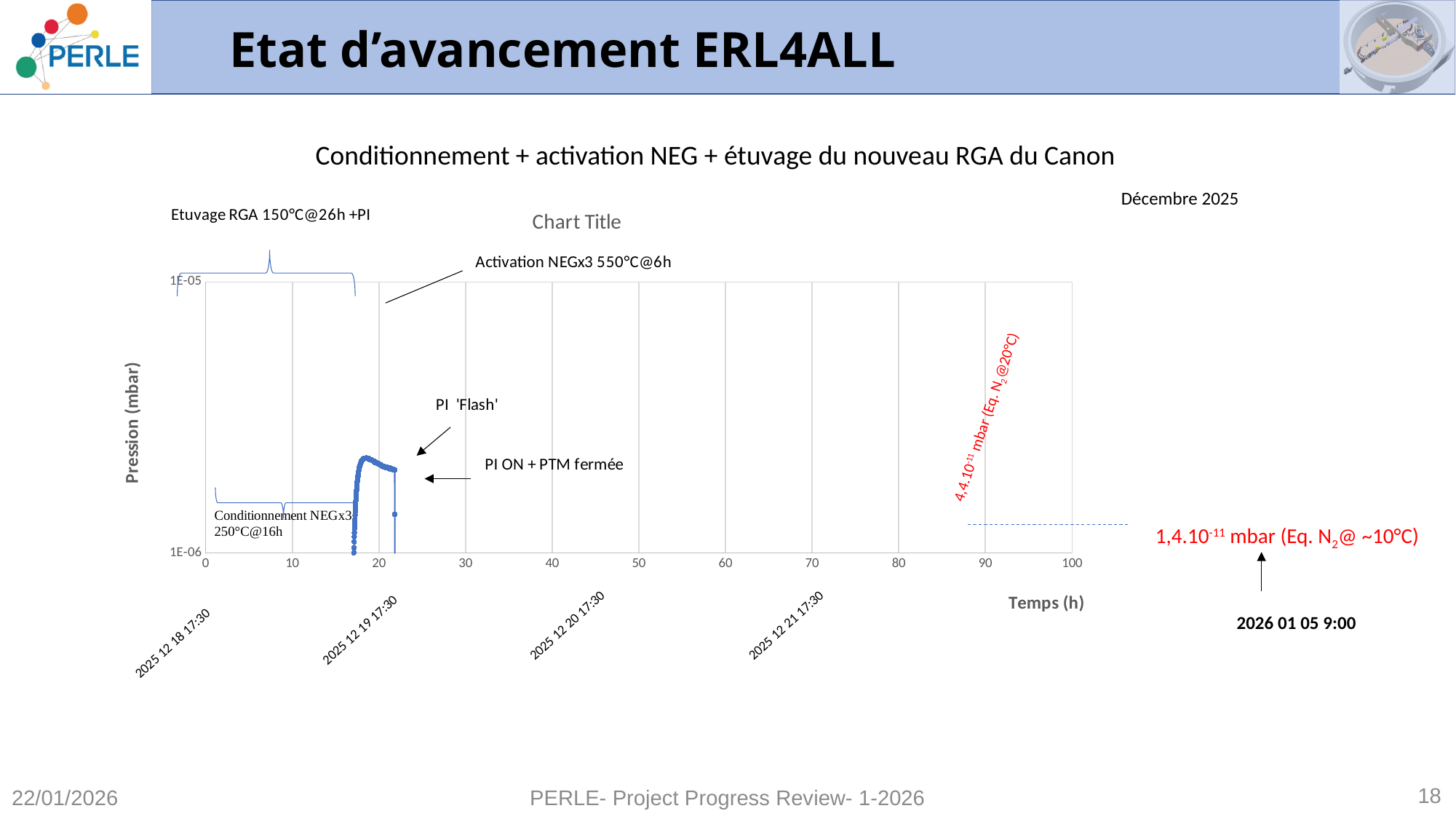
What temperature and duration are given in the 'Activation NEGx3' annotation on the chart? 550°C@6h Is the peak pressure value plotted around 18 h greater or less than 1E-05 mbar? less What is the highest tick value shown on the y axis of the chart? 1E-05 What is the title of the x axis of the chart? Temps (h) What is the lowest tick value shown on the y axis of the chart? 1E-06 What kind of chart is shown on the slide? scatter chart How many tick labels are shown on the x axis of the chart (from 0 to 100)? 11 What is the title of the y axis of the chart? Pression (mbar) Is the peak pressure value plotted around 18 h greater or less than 1E-06 mbar? greater What temperature and duration are given in the 'Conditionnement NEGx3' annotation on the chart? 250°C@16h Does the plotted pressure rise or fall between about 17 h and 18 h? rise What is the highest value shown on the x axis of the chart? 100